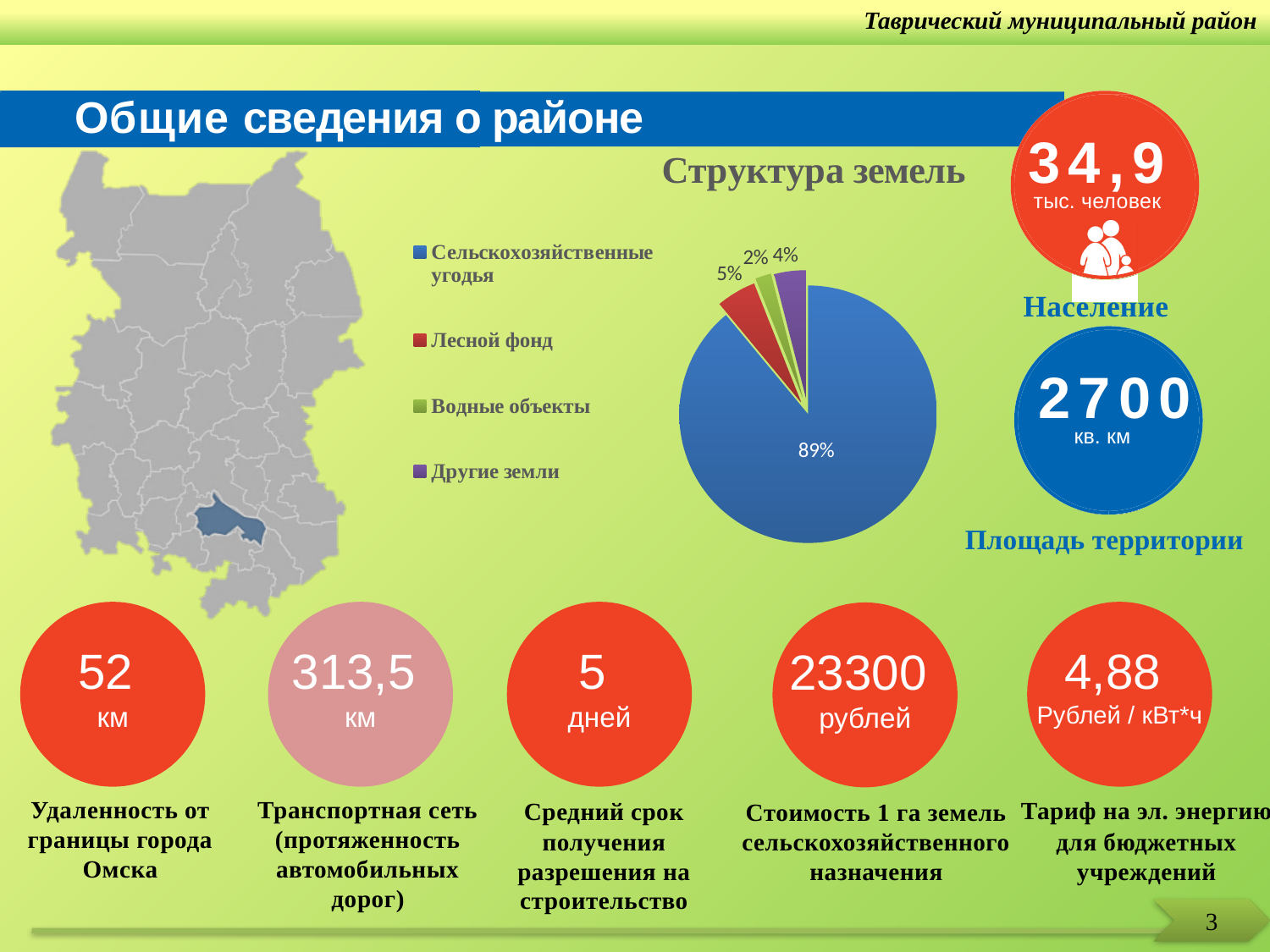
What colour is the slice for "Лесной фонд" in the pie chart? red What share of the pie chart is "Водные объекты"? 2% What is the difference in percentage points between "Сельскохозяйственные угодья" and "Лесной фонд" in the pie chart? 84 What type of chart is shown under the title "Структура земель"? pie chart Which category has the smallest slice in the pie chart? Водные объекты Which category has the largest slice in the pie chart? Сельскохозяйственные угодья In the pie chart, which is larger: "Лесной фонд" or "Другие земли"? Лесной фонд What share of the pie chart is "Лесной фонд"? 5% How many categories does the legend of the pie chart list? 4 What share of the pie chart is "Другие земли"? 4% What share of the pie chart is "Сельскохозяйственные угодья"? 89% What is the title of the pie chart on the slide? Структура земель